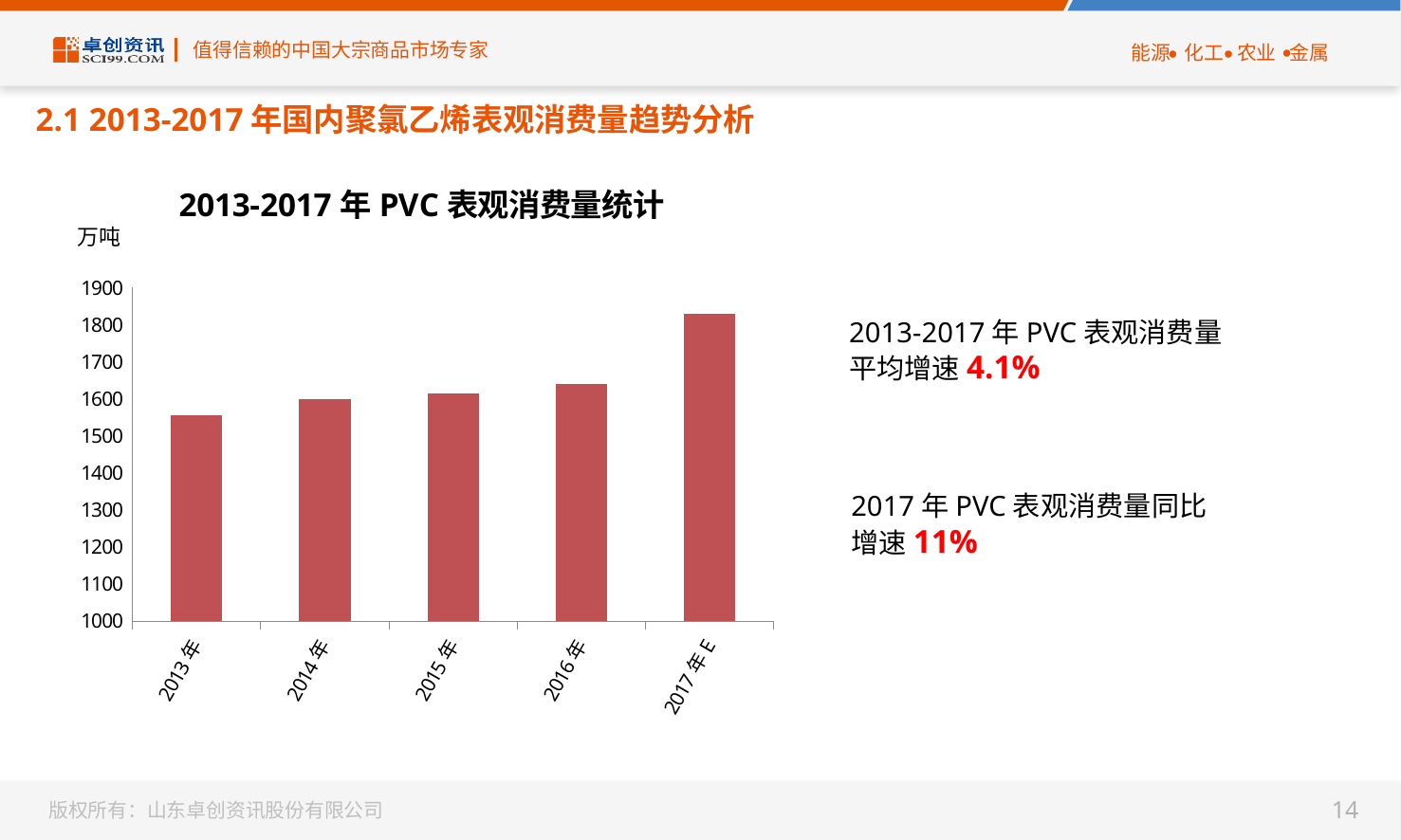
Which is larger, the value for 2016年 or the value for 2017年E? 2017年E Which is larger, the value for 2013年 or the value for 2016年? 2016年 Is the value for 2013年 greater or less than 1500? greater What unit is shown on the vertical axis of the chart? 万吨 Do the values rise or fall from 2013年 to 2017年E? rise Is the value for 2016年 greater or less than 1600? greater Is the value for 2013年 greater or less than 1600? less Which year has the lowest PVC apparent consumption in the chart? 2013年 What kind of chart is shown on the slide? bar chart How many years (bars) are plotted in the chart? 5 Which year has the highest PVC apparent consumption in the chart? 2017年E